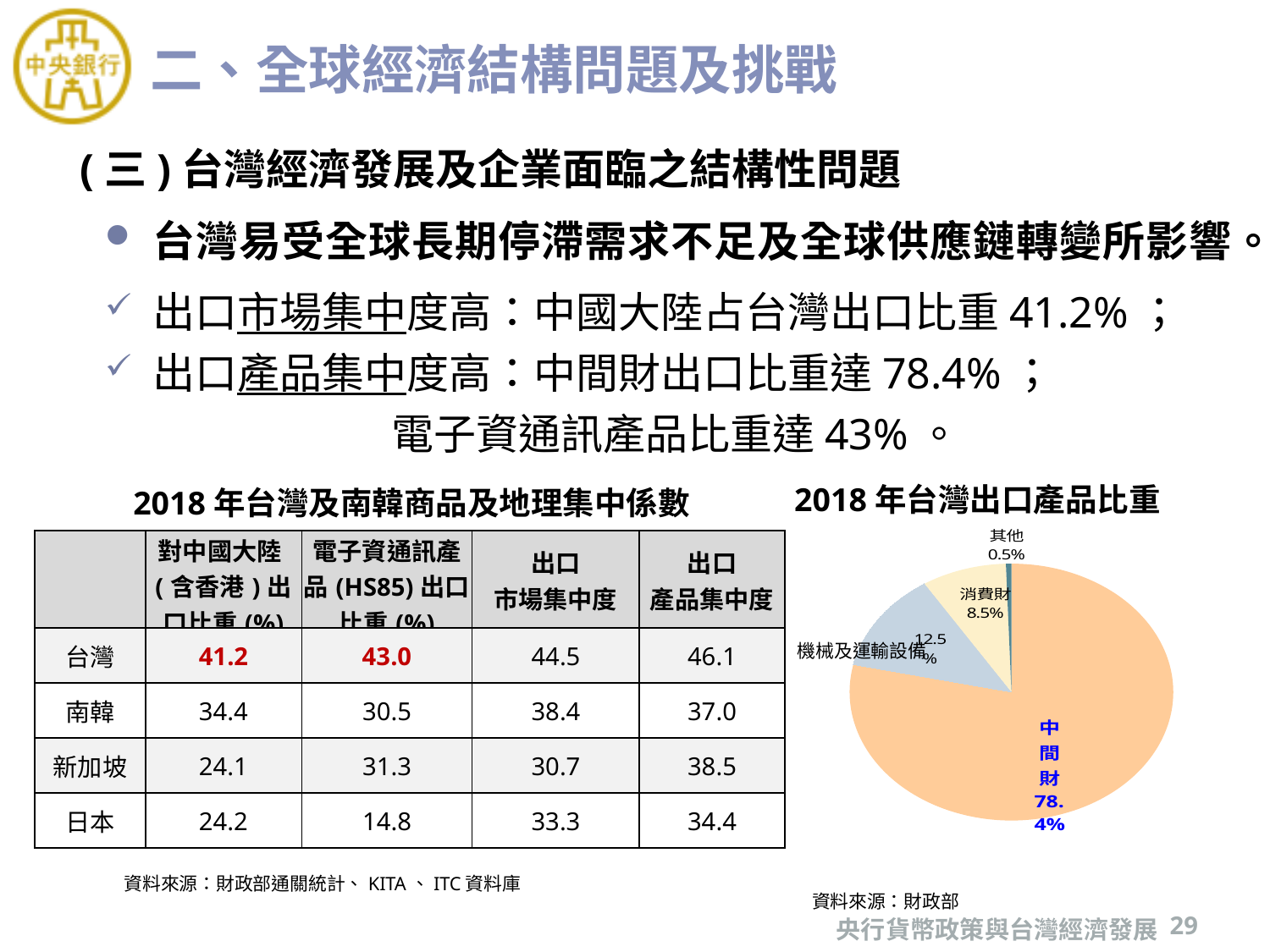
In the pie chart 2018年台灣出口產品比重, what share does 中間財 have? 78.4% In the pie chart 2018年台灣出口產品比重, what is the difference between the shares of 中間財 and 機械及運輸設備? 65.9% In the pie chart 2018年台灣出口產品比重, which is larger, 機械及運輸設備 or 消費財? 機械及運輸設備 In the pie chart 2018年台灣出口產品比重, what share does 機械及運輸設備 have? 12.5% In the pie chart 2018年台灣出口產品比重, which category has the smallest slice? 其他 In the pie chart 2018年台灣出口產品比重, what is the difference between the shares of 機械及運輸設備 and 消費財? 4.0% In the pie chart 2018年台灣出口產品比重, which category has the largest slice? 中間財 In the pie chart 2018年台灣出口產品比重, what share does 其他 have? 0.5% What kind of chart is shown under the title 2018年台灣出口產品比重? pie chart In the pie chart 2018年台灣出口產品比重, how many slices are there? 4 In the pie chart 2018年台灣出口產品比重, what share does 消費財 have? 8.5% What is the title of the pie chart on the right side of the slide? 2018年台灣出口產品比重